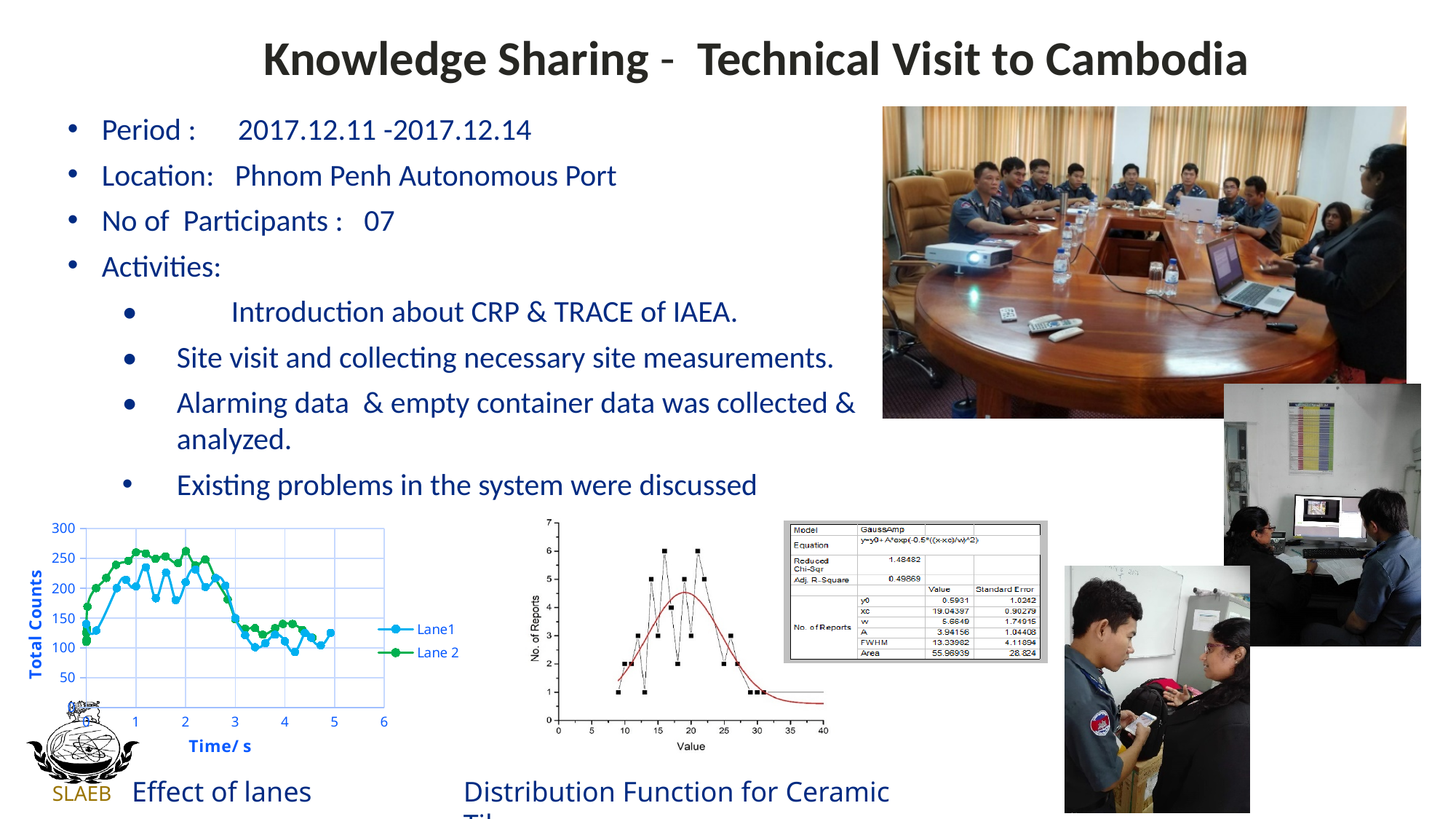
In the 'Effect of lanes' chart, is the value for Lane1 at 4 s greater or less than 150? less In the 'Effect of lanes' chart, what is the label of the vertical axis? Total Counts In the 'Distribution Function for Ceramic Tiles' chart, what model is listed in the fit table? GaussAmp In the 'Effect of lanes' chart, is the value for Lane 2 at 1 s greater or less than 200? greater In the 'Effect of lanes' chart, do the Lane 2 values rise or fall between 2.5 s and 3.5 s? fall In the 'Effect of lanes' chart, what are the names of the two series in the legend? Lane1 and Lane 2 In the 'Effect of lanes' chart, which series has the higher value at 1 s, Lane1 or Lane 2? Lane 2 In the 'Effect of lanes' chart, how many series does the legend list? 2 In the 'Distribution Function for Ceramic Tiles' chart, what is the lowest number of reports reached by any data point? 1 What kind of chart is the 'Effect of lanes' chart? Line chart In the 'Distribution Function for Ceramic Tiles' chart, what is the highest number of reports reached by any data point? 6 In the 'Distribution Function for Ceramic Tiles' chart, what is the value of xc in the fit table? 19.04397